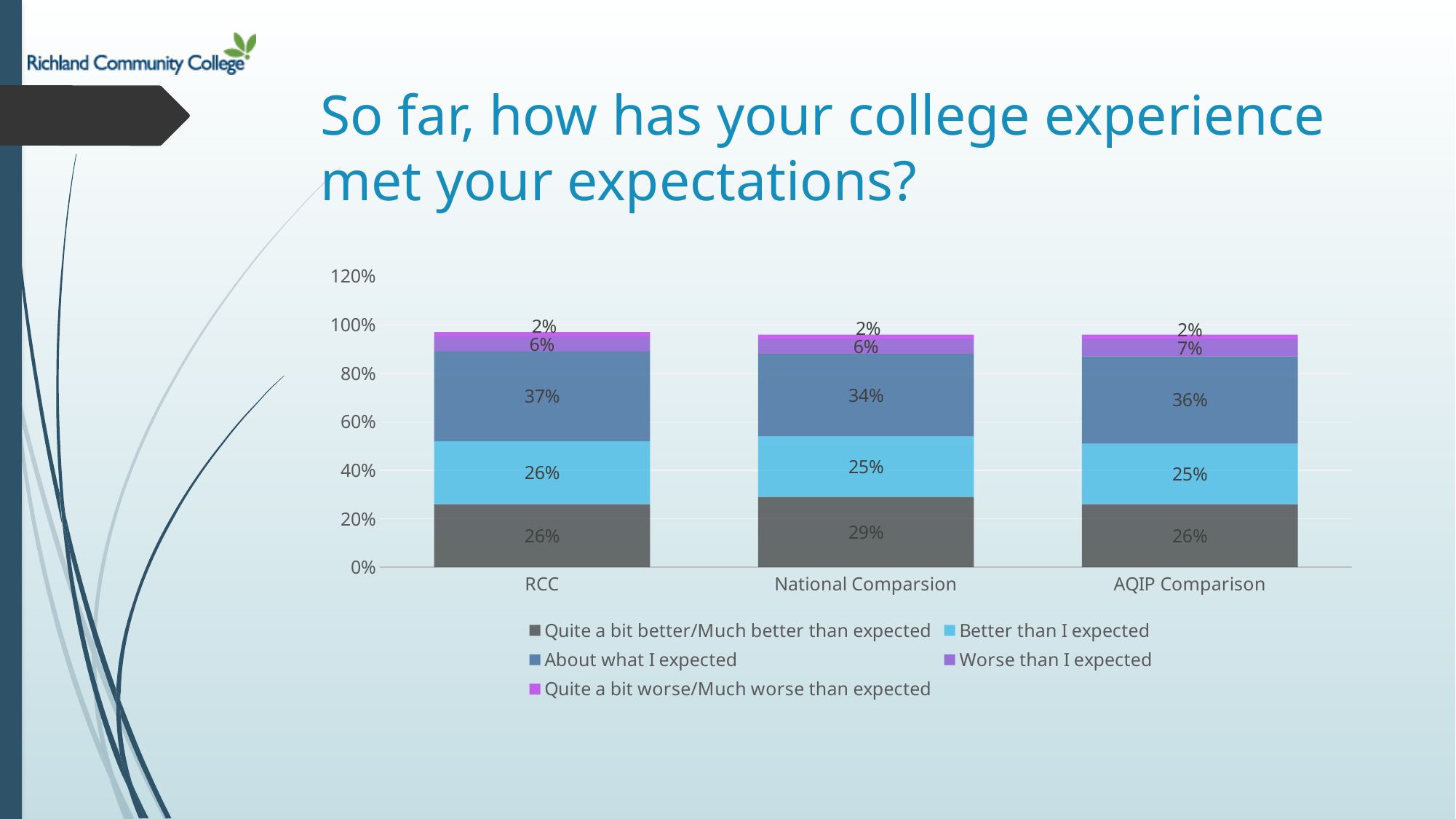
What is the difference between the 'About what I expected' values for RCC and National Comparsion? 3% What colour represents 'Quite a bit worse/Much worse than expected' in the legend? magenta/pink-purple What is the value for 'Quite a bit better/Much better than expected' for National Comparsion? 29% Which is larger: 'Better than I expected' for RCC or for AQIP Comparison? RCC How many series does the legend list? 5 Which category has the highest value for 'Quite a bit better/Much better than expected'? National Comparsion What is the value for 'Worse than I expected' for AQIP Comparison? 7% What kind of chart is shown on the slide? stacked bar chart What is the total of the stacked bar for RCC? 97% Which category has the lowest value for 'About what I expected'? National Comparsion How many categories are shown on the x axis? 3 What is the value for 'About what I expected' for RCC? 37%